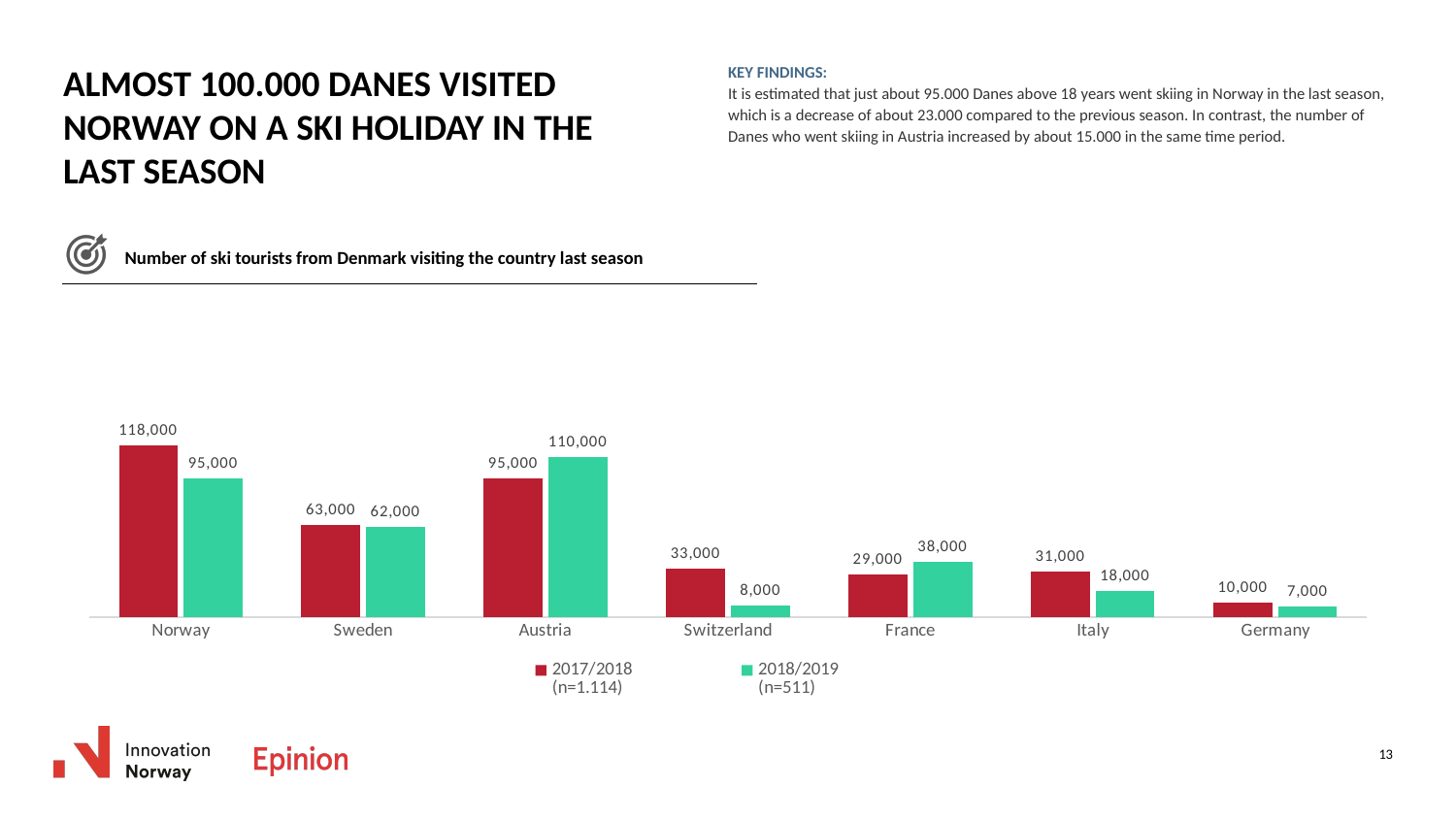
What is the sample size (n) given in the legend for the 2018/2019 series? n=511 Which country has a higher 2018/2019 value, France or Italy? France Which country has the lowest value in the 2018/2019 series? Germany By how much did the value for Austria increase from 2017/2018 to 2018/2019? 15,000 What is the difference between the 2017/2018 and 2018/2019 values for Norway? 23,000 How many series does the legend list? 2 What is the number of ski tourists from Denmark visiting Norway in 2018/2019? 95,000 Which country has the highest value in the 2017/2018 series? Norway How many countries are shown on the x axis of the chart? 7 What type of chart is shown on the slide? Bar chart What is the value for Austria in the 2017/2018 series? 95,000 Which is larger for Switzerland: the 2017/2018 value or the 2018/2019 value? 2017/2018